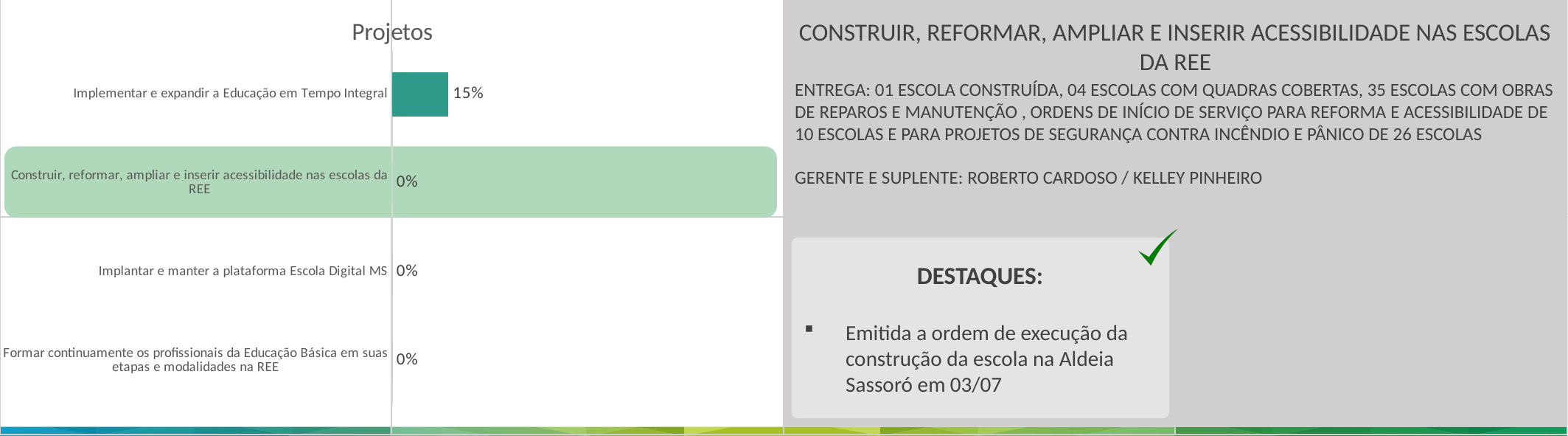
What is the difference between the value for "Implementar e expandir a Educação em Tempo Integral" and the value for "Implantar e manter a plataforma Escola Digital MS"? 15% Which project in the Projetos chart is highlighted with a green background? Construir, reformar, ampliar e inserir acessibilidade nas escolas da REE What is the value for "Implantar e manter a plataforma Escola Digital MS" in the Projetos chart? 0% Which project has the highest value in the Projetos chart? Implementar e expandir a Educação em Tempo Integral What is the value for "Construir, reformar, ampliar e inserir acessibilidade nas escolas da REE" in the Projetos chart? 0% How many projects are shown in the Projetos chart? 4 What is the value for "Formar continuamente os profissionais da Educação Básica em suas etapas e modalidades na REE" in the Projetos chart? 0% How many projects in the Projetos chart have a value of 0%? 3 What kind of chart is the Projetos chart? Bar chart What is the title of the chart on the slide? Projetos What is the value for "Implementar e expandir a Educação em Tempo Integral" in the Projetos chart? 15% Which is larger: the value for "Implementar e expandir a Educação em Tempo Integral" or the value for "Construir, reformar, ampliar e inserir acessibilidade nas escolas da REE"? Implementar e expandir a Educação em Tempo Integral